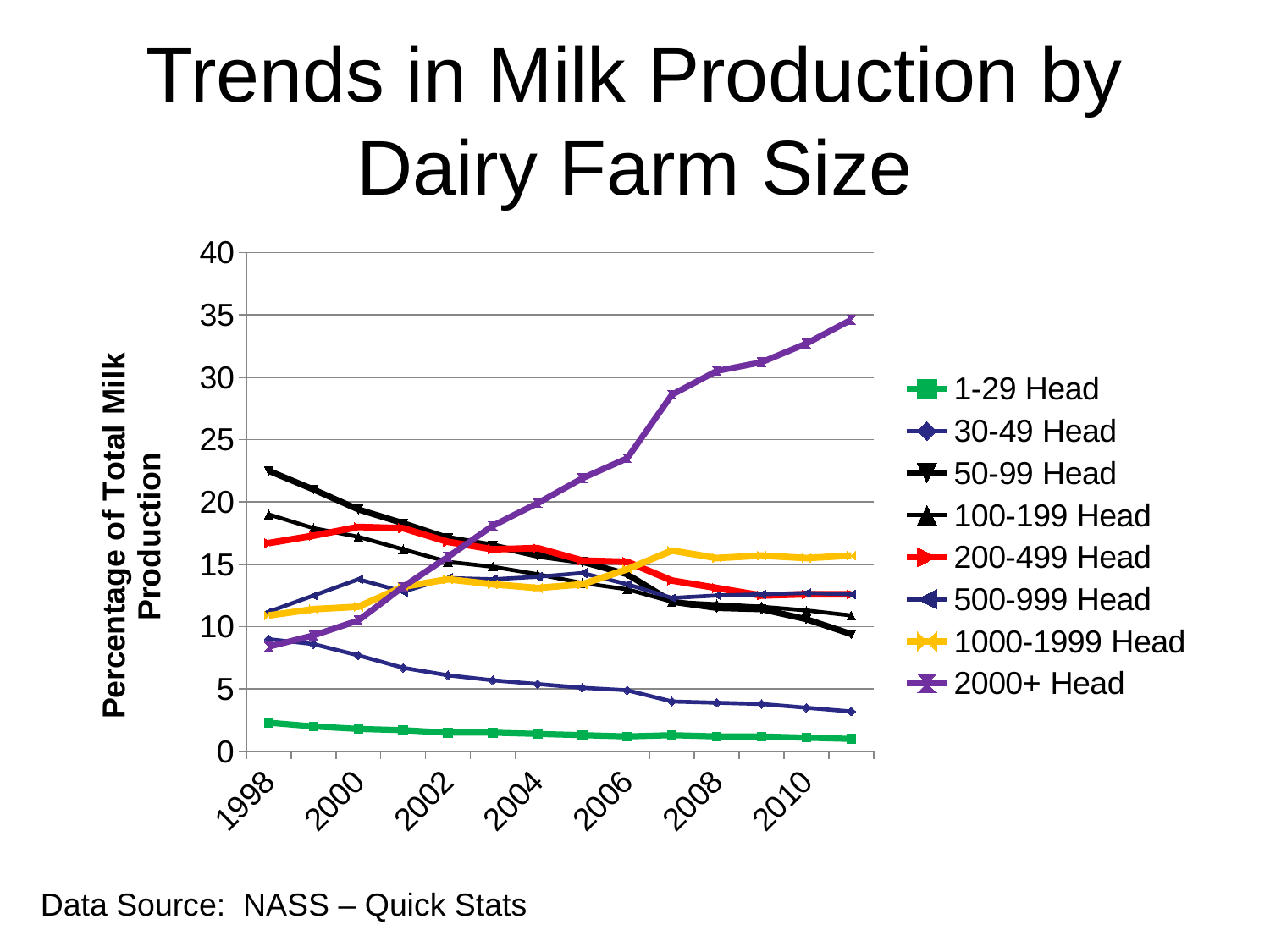
Which series has the lowest value in 2011? 1-29 Head In 1998, which is larger: the value for 50-99 Head or the value for 2000+ Head? 50-99 Head Which series has the highest value in 2011? 2000+ Head Does the 1-29 Head series rise or fall across the years shown? fall How many series does the legend list? 8 Is the value for 2000+ Head in 2011 greater or less than 30? greater Does the 50-99 Head series rise or fall from 1998 to 2011? fall Does the 2000+ Head series rise or fall from 1998 to 2011? rise Is the value for 1-29 Head in 1998 greater or less than 5? less What kind of chart is shown on the slide? line chart What is the label on the vertical axis? Percentage of Total Milk Production Is the value for 50-99 Head in 1998 greater or less than 20? greater